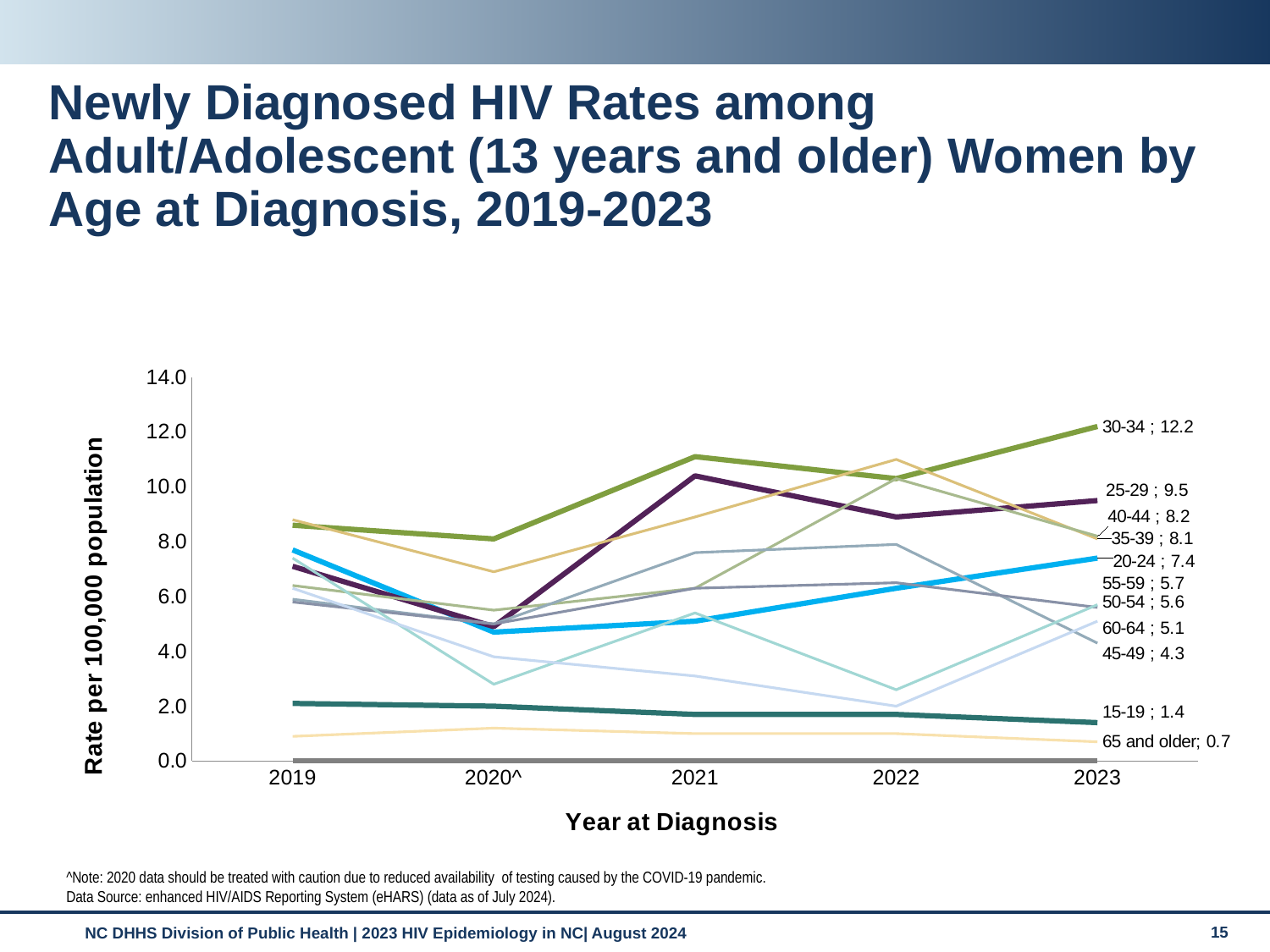
What is the 2023 rate for the 20-24 age group? 7.4 Which age group has the highest rate in 2023? 30-34 Is the value for the 30-34 age group in 2021 greater or less than 10.0? greater Which age group has the lowest rate in 2023? 65 and older What is the difference between the 2023 rates for the 30-34 and 25-29 age groups? 2.7 In 2023, which age group has the larger rate, 45-49 or 60-64? 60-64 Is the value for the 15-19 age group in 2019 greater or less than 4.0? less What is the 2023 rate for the 65 and older age group? 0.7 What kind of chart is shown on the slide? Line chart How many years are shown on the x axis? 5 What is the 2023 rate for the 30-34 age group? 12.2 What is the title of the y axis? Rate per 100,000 population